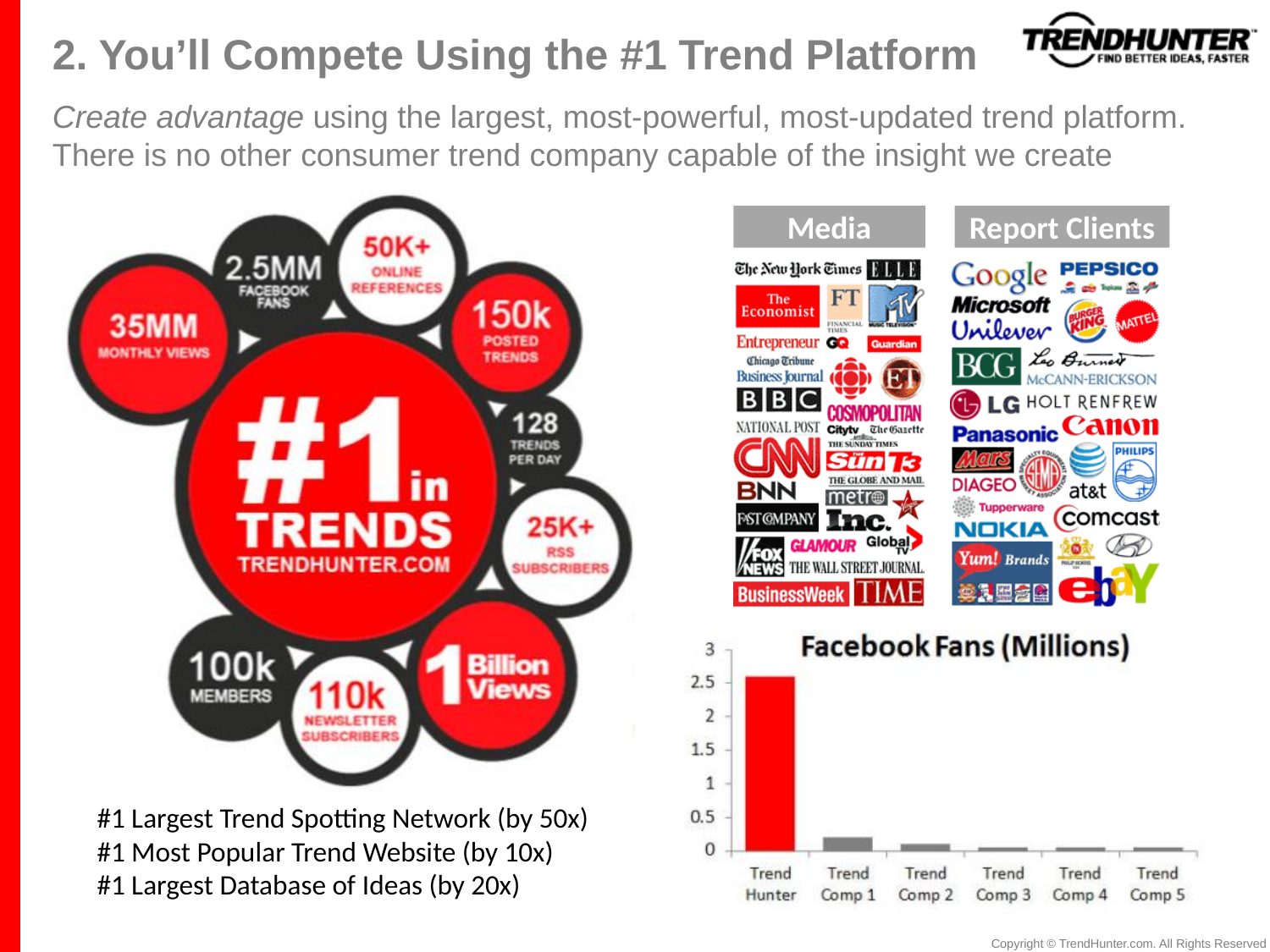
What is the highest value shown on the y axis of the Facebook Fans (Millions) chart? 3 In the Facebook Fans (Millions) chart, which is larger, the value for Trend Comp 1 or the value for Trend Comp 2? Trend Comp 1 What colour is the Trend Hunter bar in the Facebook Fans (Millions) chart? red In the Facebook Fans (Millions) chart, is the value for Trend Comp 2 greater or less than 1? less What kind of chart is the Facebook Fans (Millions) chart? bar chart Do the values in the Facebook Fans (Millions) chart rise or fall from left to right along the x axis? fall In the Facebook Fans (Millions) chart, is the value for Trend Hunter greater or less than 2? greater Which category has the highest value in the Facebook Fans (Millions) chart? Trend Hunter What is the title of the chart at the bottom right of the slide? Facebook Fans (Millions) In the Facebook Fans (Millions) chart, which is larger, the value for Trend Hunter or the value for Trend Comp 1? Trend Hunter How many categories are shown on the x axis of the Facebook Fans (Millions) chart? 6 In the Facebook Fans (Millions) chart, is the value for Trend Comp 1 greater or less than 0.5? less